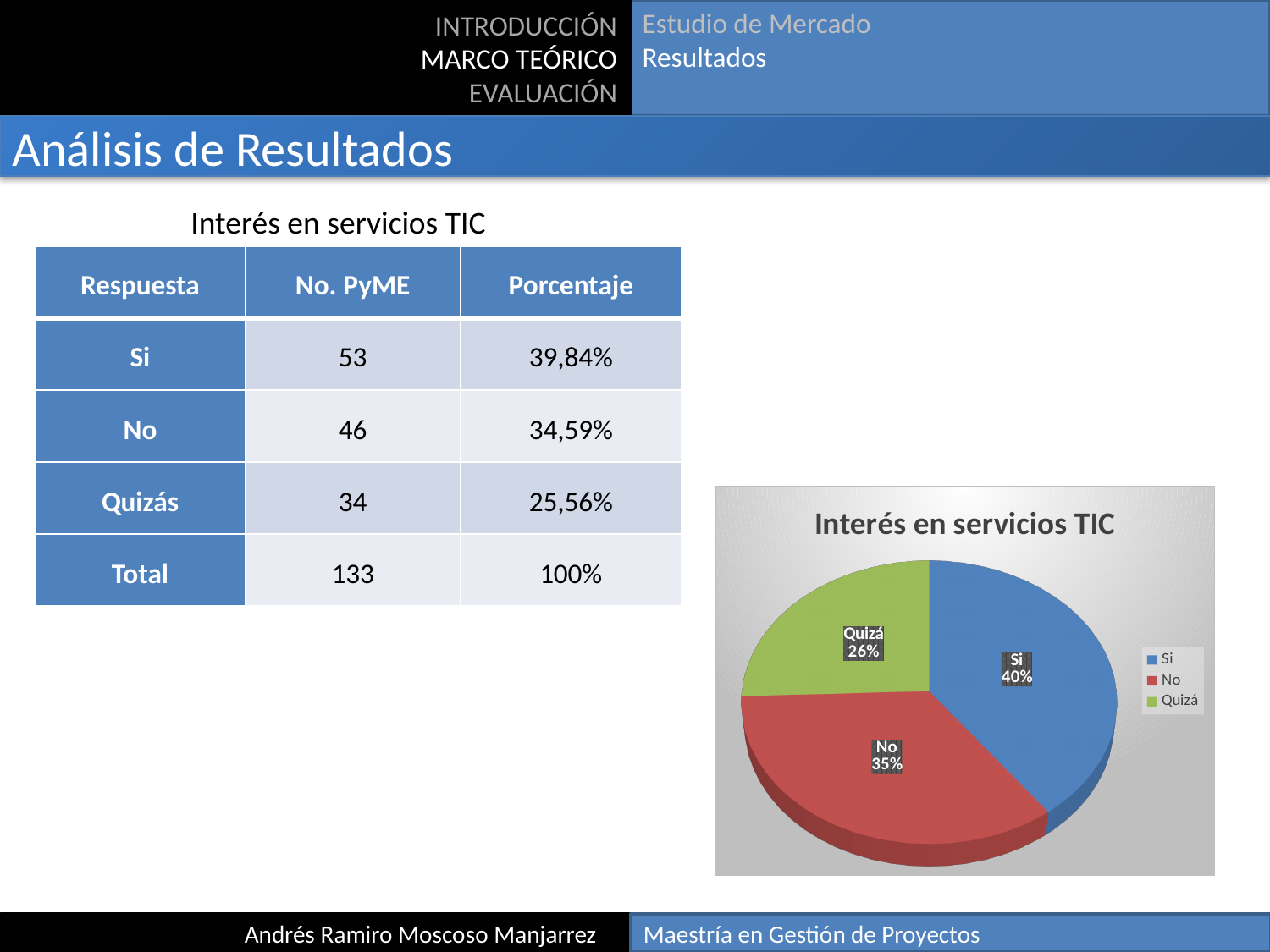
Which category has the smallest slice in the pie chart? Quizá How many slices does the pie chart have? 3 How many entries does the legend of the pie chart list? 3 Which slice is larger in the pie chart, 'No' or 'Quizá'? No What type of chart is shown on the slide? pie chart What percentage does the 'Si' slice show in the pie chart? 40% What percentage does the 'No' slice show in the pie chart? 35% What colour is the 'No' slice in the pie chart? red Which category has the largest slice in the pie chart? Si What percentage does the 'Quizá' slice show in the pie chart? 26% What is the difference in percentage points between the 'Si' and 'No' slices in the pie chart? 5 What is the title of the chart? Interés en servicios TIC